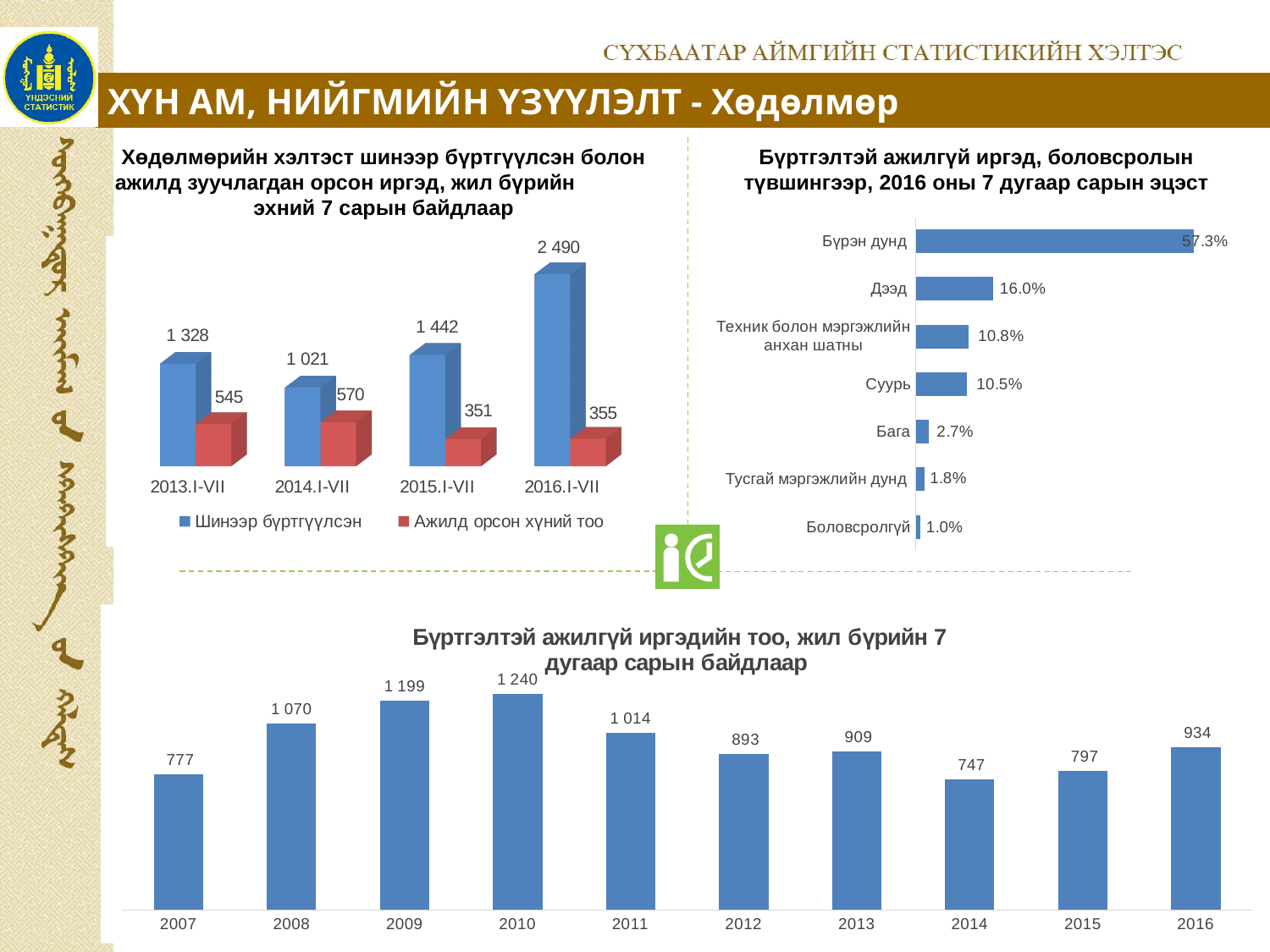
In the top-right chart (Бүртгэлтэй ажилгүй иргэд, боловсролын түвшингээр), which education level has the highest share? Бүрэн дунд What kind of chart is the bottom chart (Бүртгэлтэй ажилгүй иргэдийн тоо)? Bar chart In the top-left chart (Хөдөлмөрийн хэлтэст шинээр бүртгүүлсэн...), what is the difference between Шинээр бүртгүүлсэн and Ажилд орсон хүний тоо in 2015.I-VII? 1 091 In the bottom chart (Бүртгэлтэй ажилгүй иргэдийн тоо), which year has the highest value? 2010 In the top-left chart (Хөдөлмөрийн хэлтэст шинээр бүртгүүлсэн...), what is the value for Ажилд орсон хүний тоо in 2014.I-VII? 570 In the bottom chart (Бүртгэлтэй ажилгүй иргэдийн тоо), which is larger, the value for 2012 or the value for 2013? 2013 In the top-left chart (Хөдөлмөрийн хэлтэст шинээр бүртгүүлсэн...), how many series does the legend list? 2 In the top-right chart (Бүртгэлтэй ажилгүй иргэд, боловсролын түвшингээр), which category has the lowest value? Боловсролгүй In the top-right chart (Бүртгэлтэй ажилгүй иргэд, боловсролын түвшингээр), how many categories are shown? 7 In the top-right chart (Бүртгэлтэй ажилгүй иргэд, боловсролын түвшингээр), what is the value for Дээд? 16.0% In the bottom chart (Бүртгэлтэй ажилгүй иргэдийн тоо), what is the value for 2014? 747 In the top-left chart (Хөдөлмөрийн хэлтэст шинээр бүртгүүлсэн...), what is the value for Шинээр бүртгүүлсэн in 2016.I-VII? 2 490